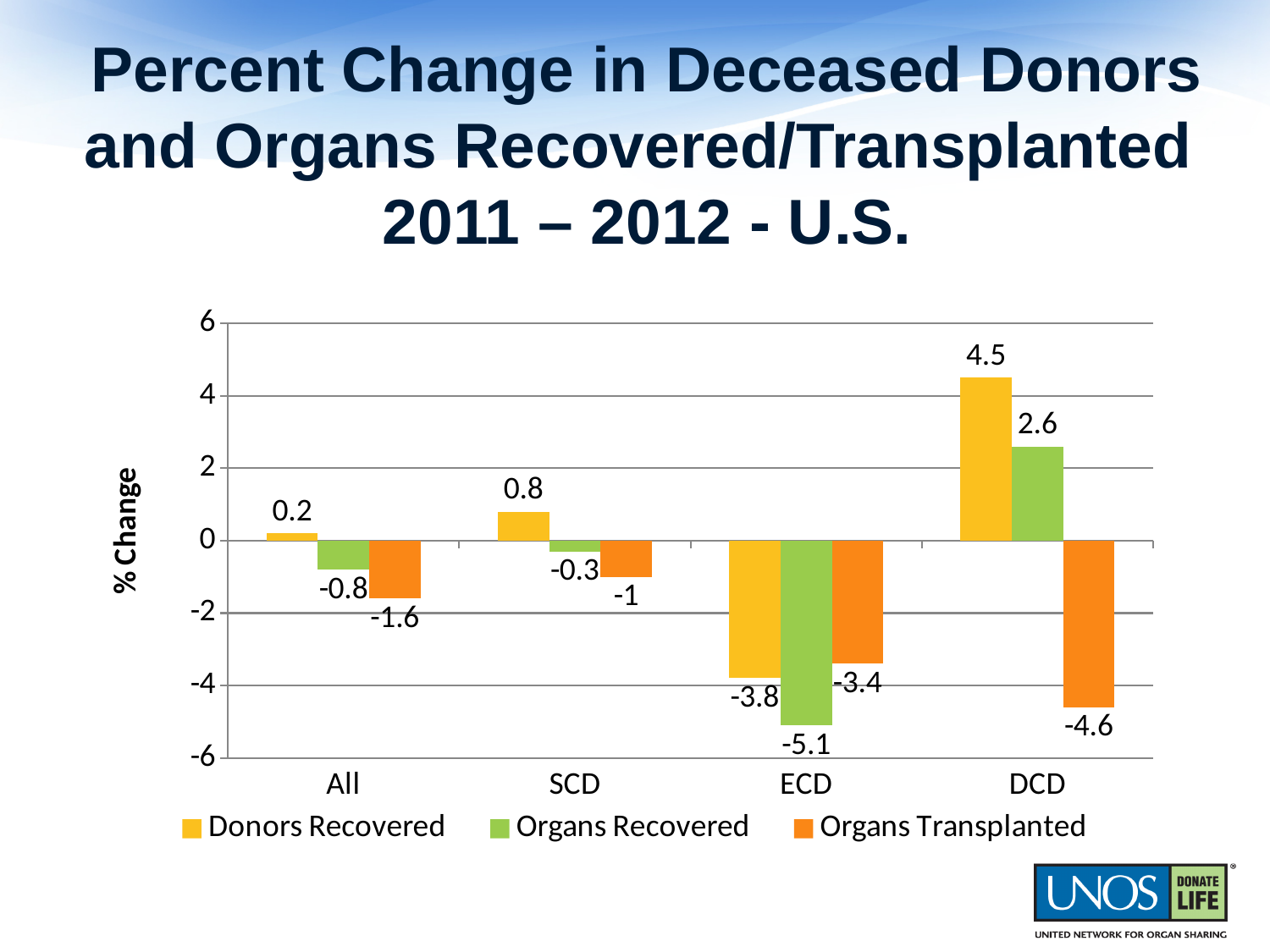
What is the value for Organs Transplanted in the All category? -1.6 Which is larger in the ECD category: the Donors Recovered value or the Organs Transplanted value? Organs Transplanted How many series does the legend list? 3 What is the value for Donors Recovered in the DCD category? 4.5 What kind of chart is shown on the slide? Bar chart What is the value for Organs Transplanted in the SCD category? -1 How many categories are shown on the x axis? 4 What is the value for Organs Recovered in the ECD category? -5.1 What is the label of the y axis? % Change What is the difference between the Donors Recovered and Organs Recovered values in the DCD category? 1.9 Which category has the highest value for Donors Recovered? DCD Which category has the lowest value for Organs Transplanted? DCD